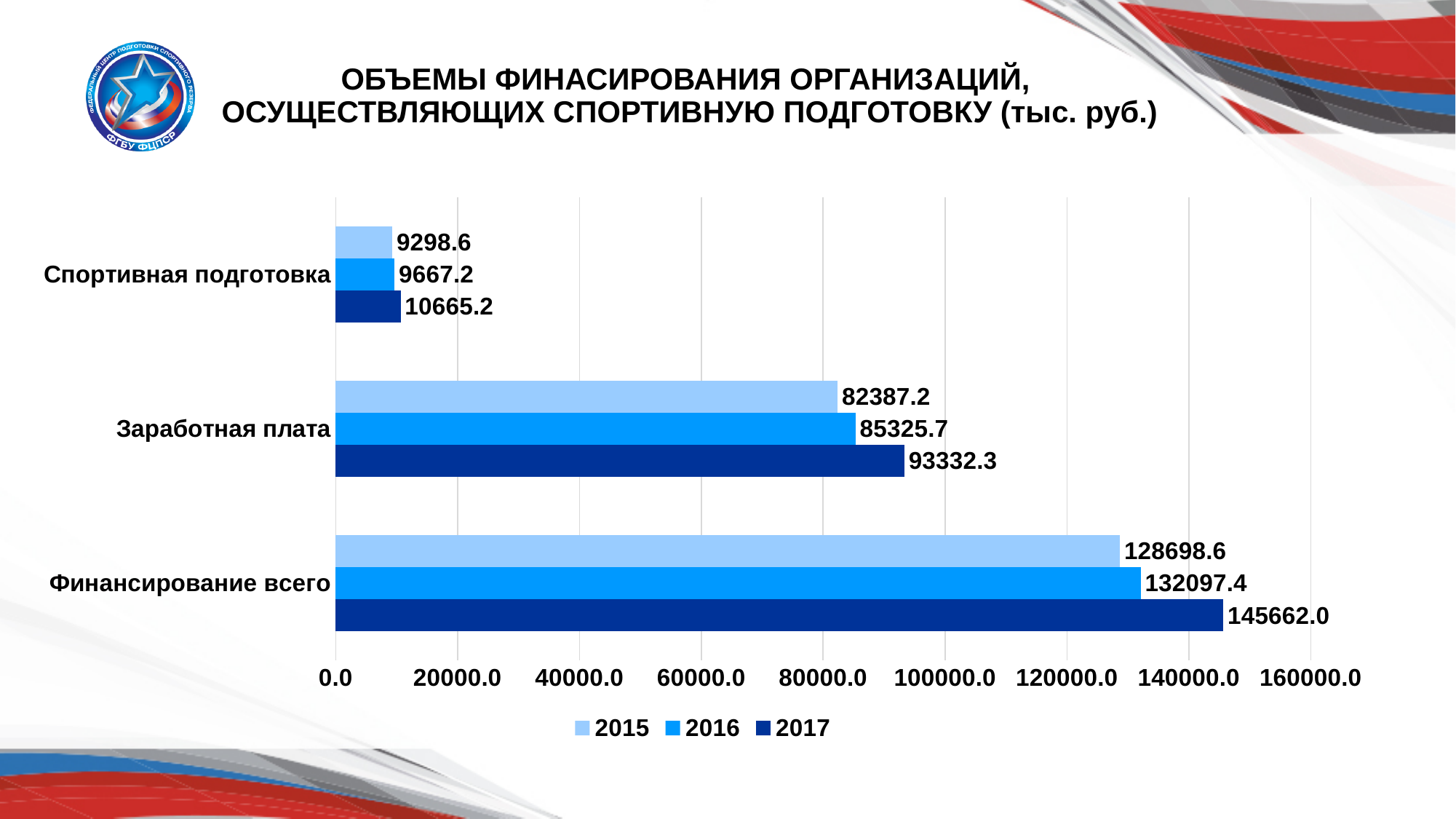
What type of chart is shown on the slide? bar chart What is the difference between the 2017 and 2016 values for Заработная плата? 8006.6 Which category has the lowest value in 2015? Спортивная подготовка What is the difference between the 2017 and 2015 values for Финансирование всего? 16963.4 Which is larger for Спортивная подготовка: the 2015 value or the 2017 value? 2017 What is the value for Заработная плата in 2015? 82387.2 What is the value for Финансирование всего in 2017? 145662.0 How many series does the legend list? 3 Which category has the highest value in 2017? Финансирование всего Which year is represented by the darkest blue bars in the legend? 2017 How many categories are shown on the chart? 3 What is the value for Спортивная подготовка in 2016? 9667.2